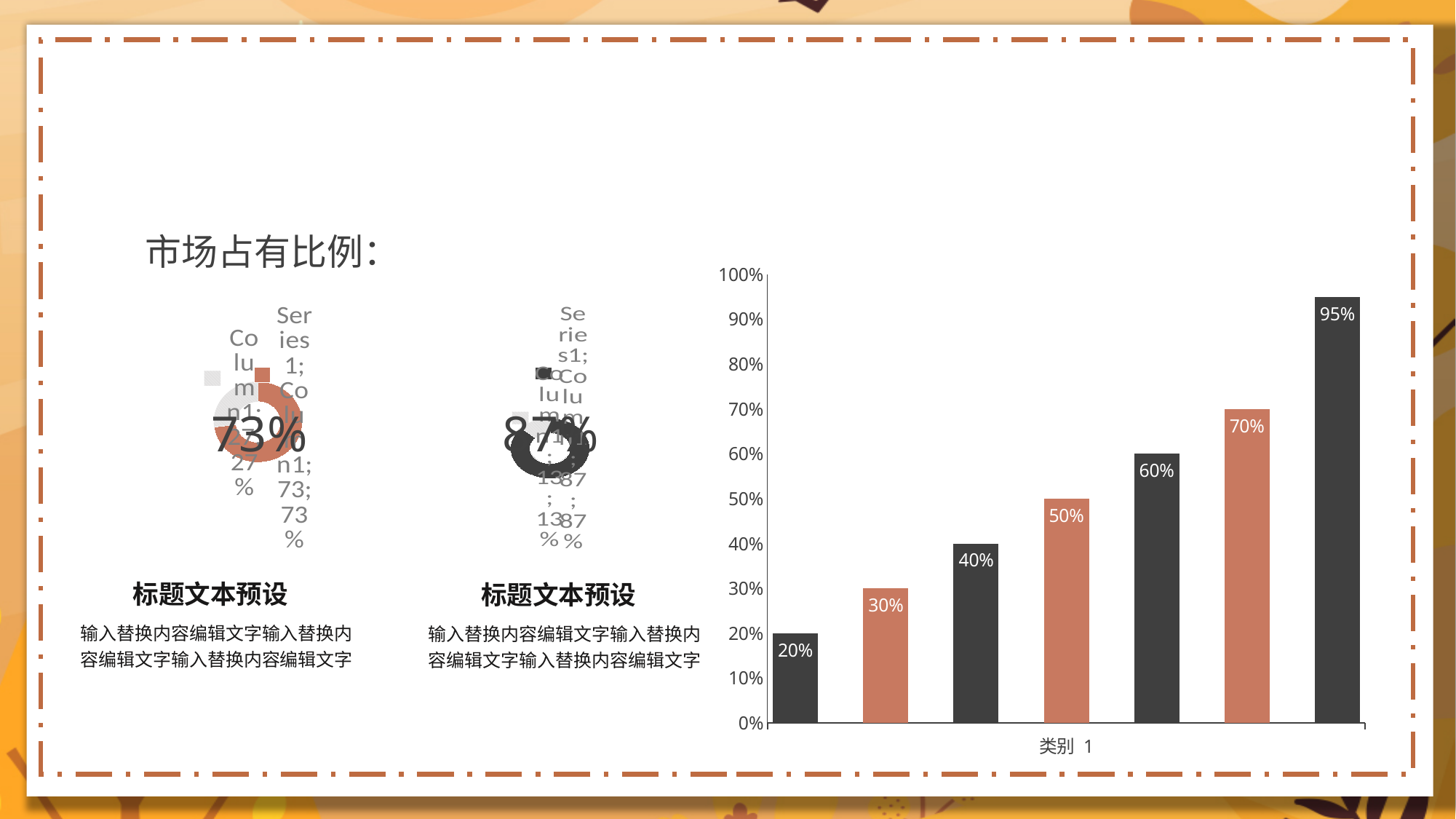
What kind of chart is shown on the right side of the slide? bar chart In the bar chart on the right, how many bars are plotted? 7 In the bar chart on the right, do the bar values rise or fall from left to right? rise In the bar chart on the right, which is larger: the third bar from the left or the fifth bar from the left? the fifth bar (60%) In the bar chart on the right, what is the label shown on the horizontal axis? 类别 1 In the bar chart on the right, what is the difference between the tallest bar and the shortest bar? 75% In the bar chart on the right, what is the highest value shown on the vertical axis? 100% In the bar chart on the right, what is the value of the tallest bar? 95% In the bar chart on the right, what is the value of the fourth bar from the left? 50% In the bar chart on the right, what is the difference between the sixth bar (70%) and the fifth bar (60%)? 10% In the bar chart on the right, what is the value of the shortest bar? 20% In the bar chart on the right, what is the value of the second bar from the left? 30%